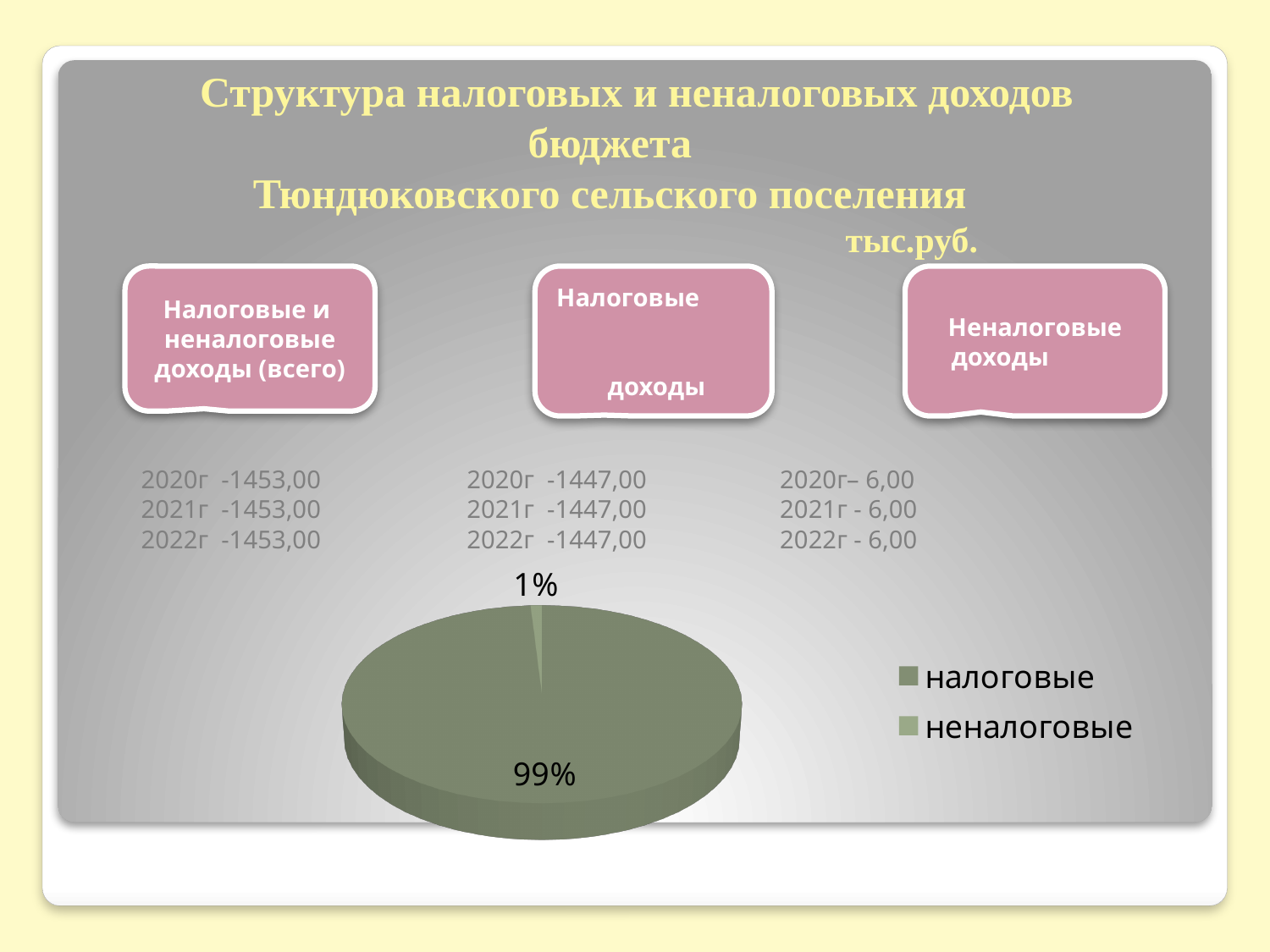
Which slice of the pie chart is the largest? налоговые Which legend entry is shown in the darker green colour? налоговые What share of the pie does the "неналоговые" slice represent? 1% How many slices does the pie chart have? 2 What are the two legend entries of the pie chart? налоговые, неналоговые What kind of chart is shown on the slide? pie chart By how many percentage points does the "налоговые" share exceed the "неналоговые" share? 98 What share of the pie does the "налоговые" slice represent? 99% Which is larger in the pie chart, "налоговые" or "неналоговые"? налоговые Is the share for "налоговые" greater or less than 50%? greater Which slice of the pie chart is the smallest? неналоговые How many entries does the legend of the pie chart list? 2